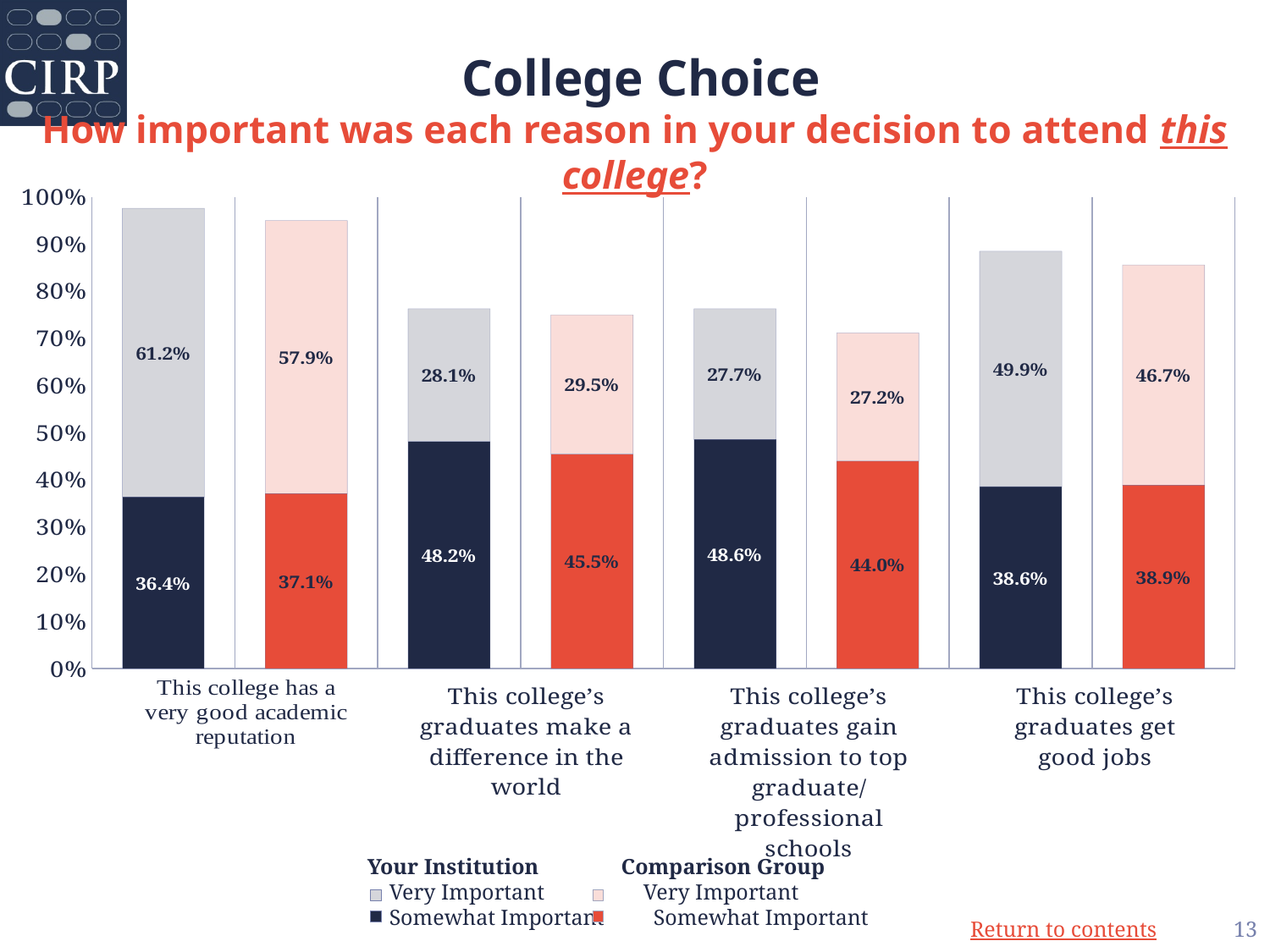
What percentage of Your Institution students rated 'This college has a very good academic reputation' as Very Important? 61.2% What kind of chart is shown on the slide? Stacked bar chart What percentage of the Comparison Group rated 'This college's graduates gain admission to top graduate/professional schools' as Somewhat Important? 44.0% What colour represents Your Institution's Somewhat Important responses? Dark navy blue For 'This college's graduates make a difference in the world', which is larger: Your Institution's Somewhat Important percentage or the Comparison Group's Somewhat Important percentage? Your Institution (48.2%) What is the difference between Your Institution's and the Comparison Group's Very Important percentages for 'This college has a very good academic reputation'? 3.3 percentage points Which reason has the highest Very Important percentage for Your Institution? This college has a very good academic reputation What is the combined (Somewhat Important plus Very Important) percentage for Your Institution on 'This college's graduates get good jobs'? 88.5% What percentage of the Comparison Group rated 'This college's graduates get good jobs' as Very Important? 46.7% Which reason has the lowest Very Important percentage for the Comparison Group? This college's graduates gain admission to top graduate/professional schools How many series does the legend list? 4 How many reasons (categories) are shown along the x axis? 4